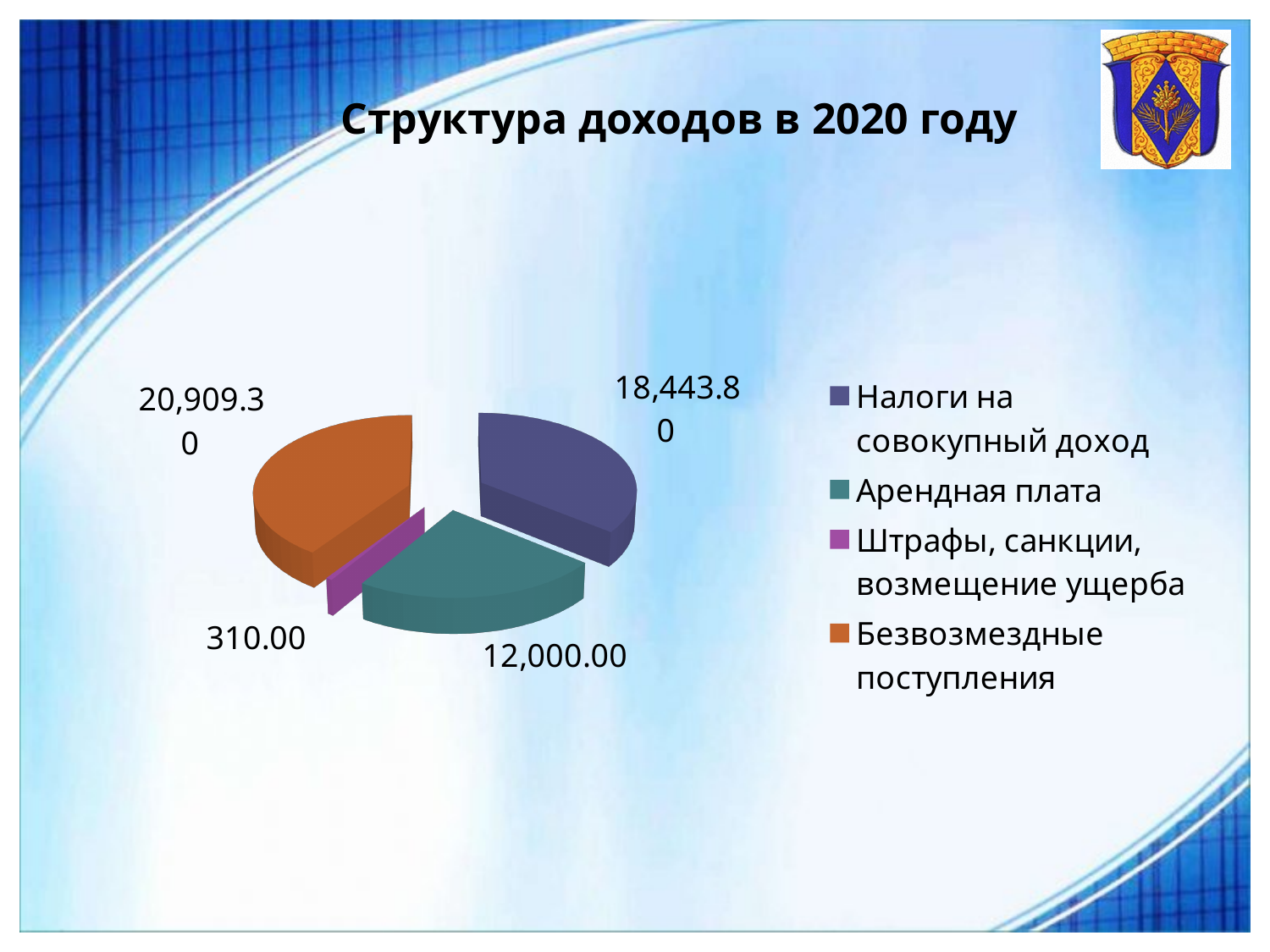
What is the difference between Налоги на совокупный доход and Арендная плата? 6,443.80 Which category has the largest value? Безвозмездные поступления What is the value for Штрафы, санкции, возмещение ущерба? 310.00 What kind of chart is shown on the slide? Pie chart Which is larger, Арендная плата or Налоги на совокупный доход? Налоги на совокупный доход What is the value for Налоги на совокупный доход? 18,443.80 Which category has the smallest value? Штрафы, санкции, возмещение ущерба What is the title of the chart? Структура доходов в 2020 году What is the value for Безвозмездные поступления? 20,909.30 What is the value for Арендная плата? 12,000.00 What is the difference between Безвозмездные поступления and Налоги на совокупный доход? 2,465.50 How many categories does the pie chart show? 4